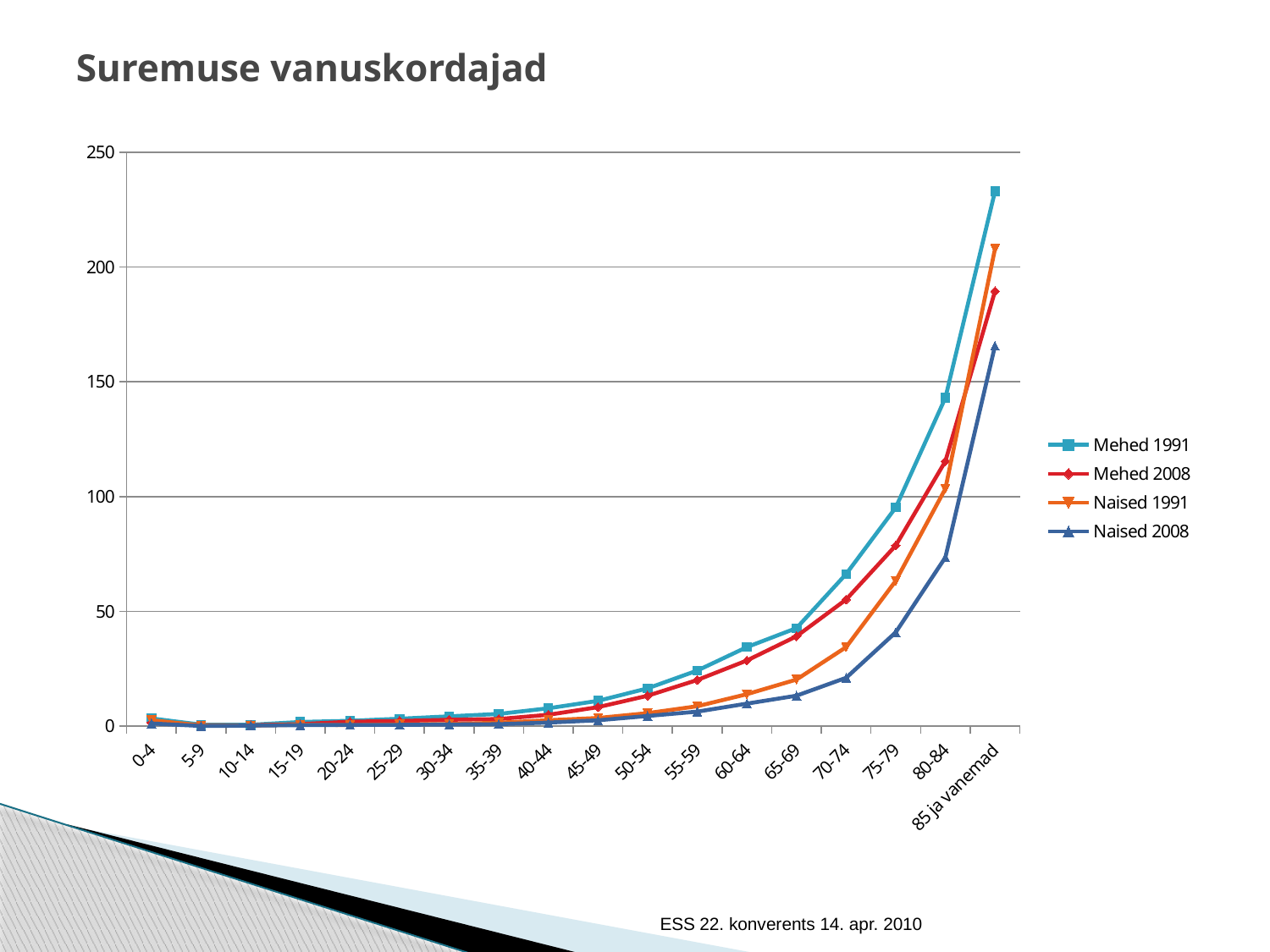
How many series does the legend list? 4 What kind of chart is shown on the slide? line chart Which series has the lowest value for the 85 ja vanemad age group? Naised 2008 Is the value for Naised 2008 at 75-79 greater or less than 50? less What is the title of the chart? Suremuse vanuskordajad Is the value for Mehed 1991 at 85 ja vanemad greater or less than 200? greater At 85 ja vanemad, which is larger: Naised 1991 or Mehed 2008? Naised 1991 Do the values for Mehed 2008 generally rise or fall as age increases along the x axis? rise Is the value for Naised 2008 at 85 ja vanemad greater or less than 200? less How many age-group categories are shown on the x axis? 18 Which series has the highest value for the 85 ja vanemad age group? Mehed 1991